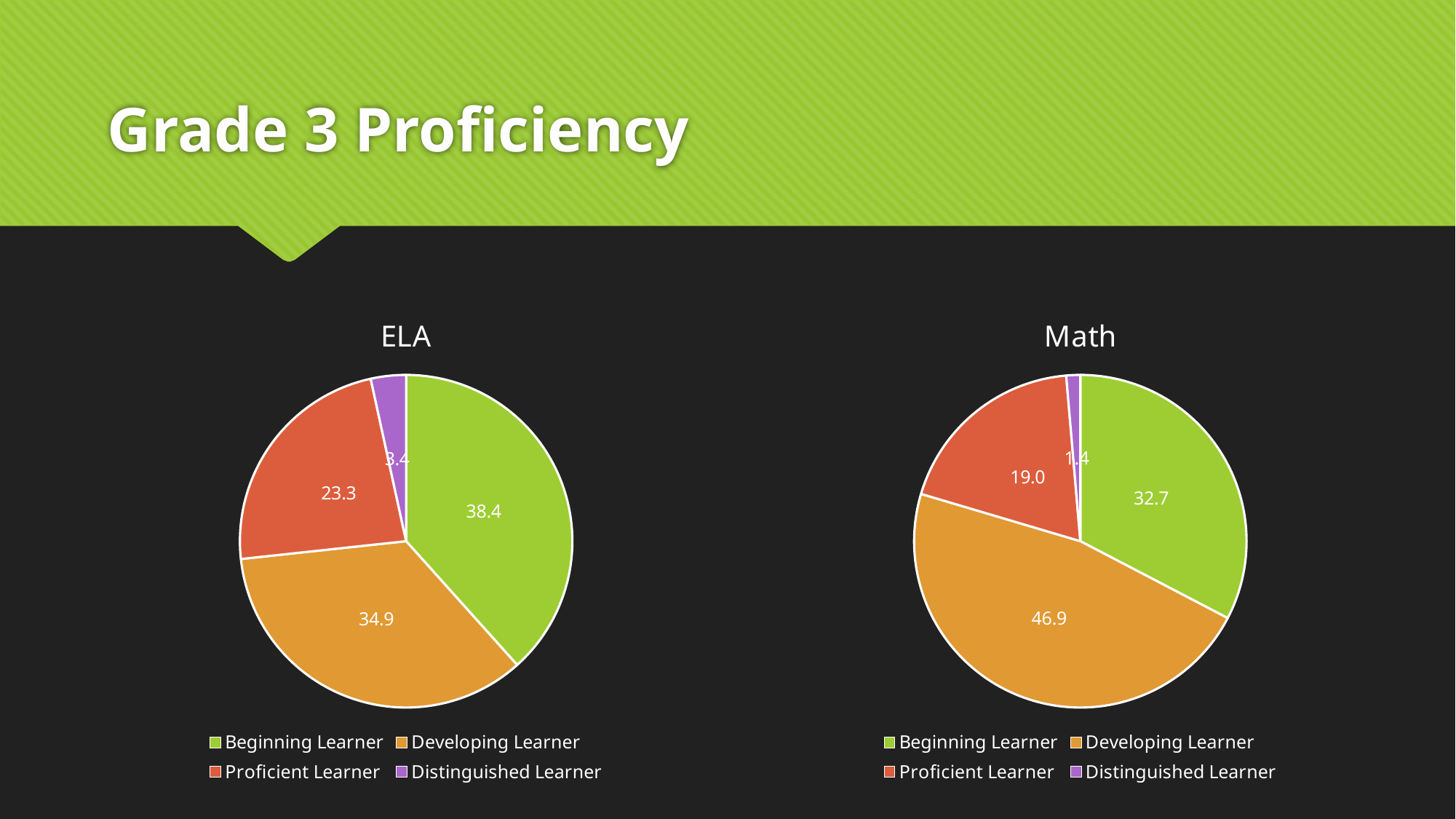
In the ELA pie chart, what is the value for Beginning Learner? 38.4 In the Math pie chart, what is the value for Developing Learner? 46.9 In the Math pie chart, what is the value for Proficient Learner? 19.0 In the ELA pie chart, what is the value for Distinguished Learner? 3.4 How many categories does the ELA pie chart show? 4 In the ELA pie chart, which category has the largest slice? Beginning Learner Which is larger: the Proficient Learner value in the ELA chart or in the Math chart? ELA In the Math pie chart, which category has the largest slice? Developing Learner In the Math pie chart, which category has the smallest slice? Distinguished Learner In the Math pie chart, what is the difference between the Developing Learner and Beginning Learner values? 14.2 In the ELA pie chart, what is the difference between the Beginning Learner and Developing Learner values? 3.5 What type of chart is used for the Math data? Pie chart